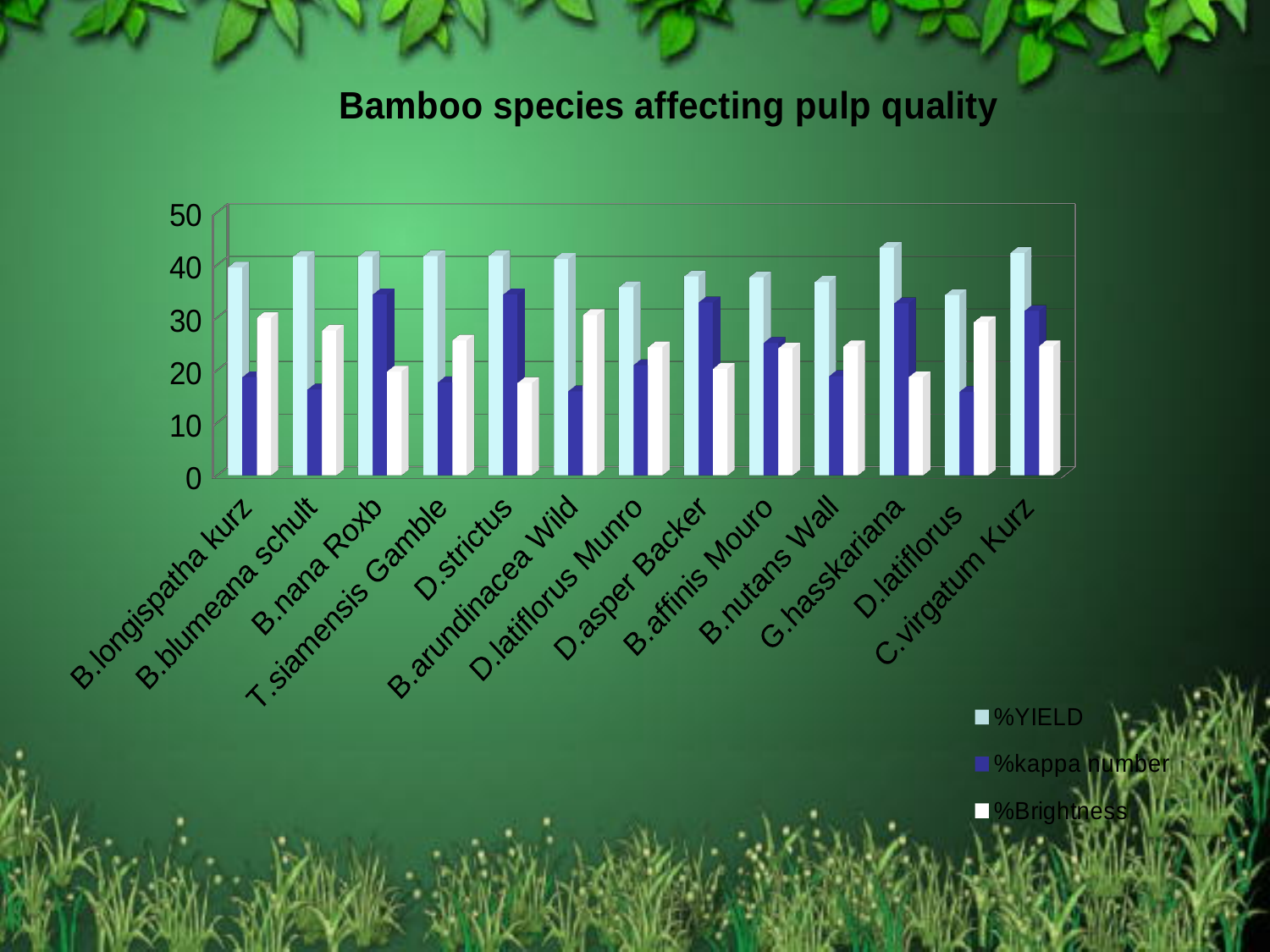
Is the %Brightness value for B.longispatha kurz greater or less than 20? greater Which series is shown in dark blue according to the legend? %kappa number For B.nana Roxb, which is larger: %kappa number or %Brightness? %kappa number How many bamboo species are shown on the x axis? 13 What is the title of the chart? Bamboo species affecting pulp quality Which species has the larger %Brightness value: B.longispatha kurz or D.strictus? B.longispatha kurz Is the %kappa number value for B.nana Roxb greater or less than 30? greater What kind of chart is shown on the slide? bar chart Is the %kappa number value for B.blumeana schult greater or less than 20? less How many series does the legend list? 3